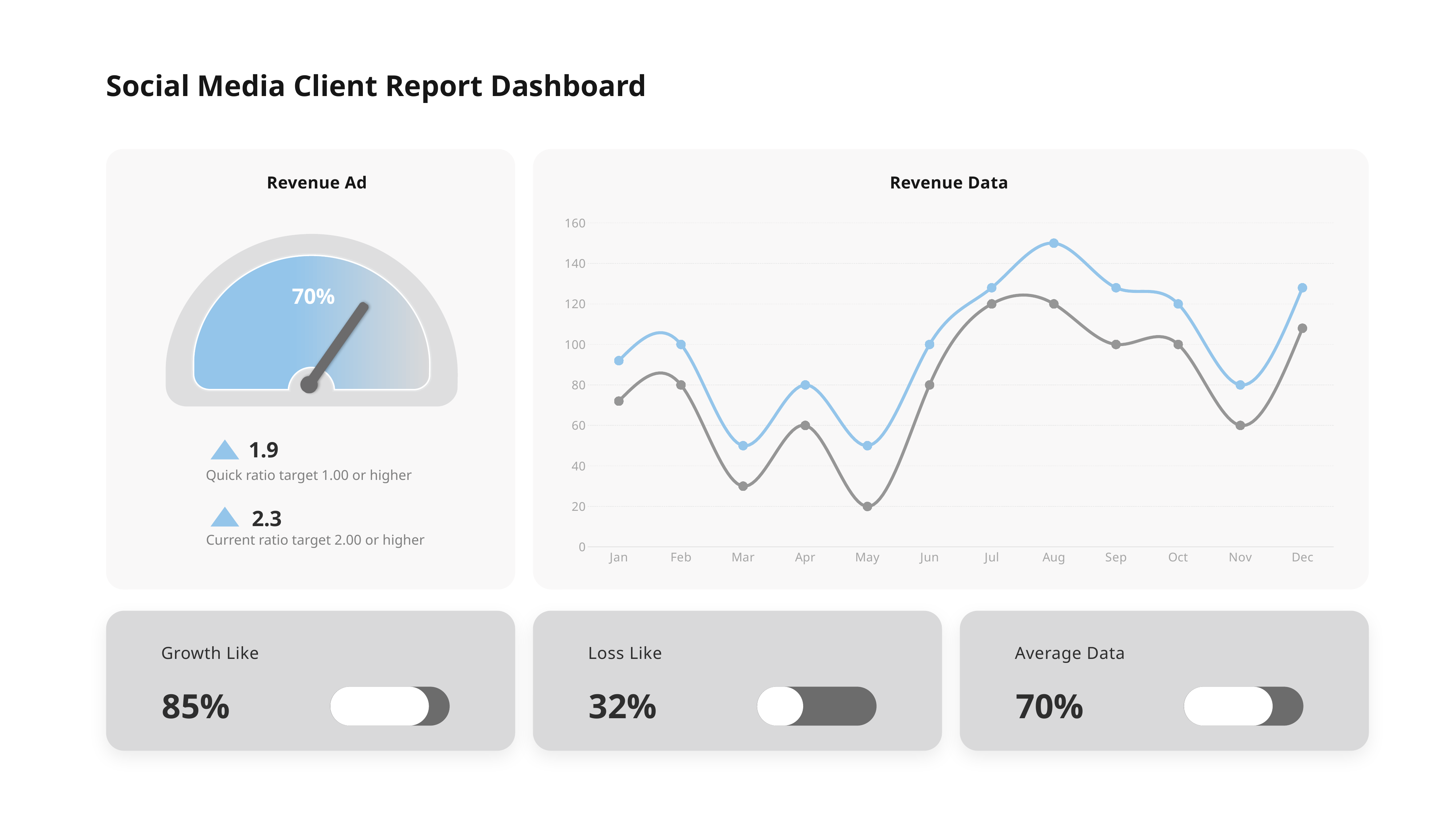
What is the title of the line chart on the slide? Revenue Data What percentage does the Revenue Ad gauge show? 70% How many lines are plotted in the Revenue Data chart? 2 In the Revenue Data chart, is the blue line's value for Dec greater or less than 120? greater What kind of chart is the Revenue Data chart? line chart In the Revenue Data chart, is the blue line's value for Aug greater or less than 140? greater How many months are plotted on the x axis of the Revenue Data chart? 12 In the Revenue Data chart, which month has the lowest value on the grey line? May In the Revenue Data chart, does the grey line rise or fall from Jan to Mar? fall In the Revenue Data chart, is the grey line's value for Mar greater or less than 40? less In the Revenue Data chart, which month has the highest value on the blue line? Aug In the Revenue Data chart, which line has the larger value in Jul, the blue line or the grey line? the blue line